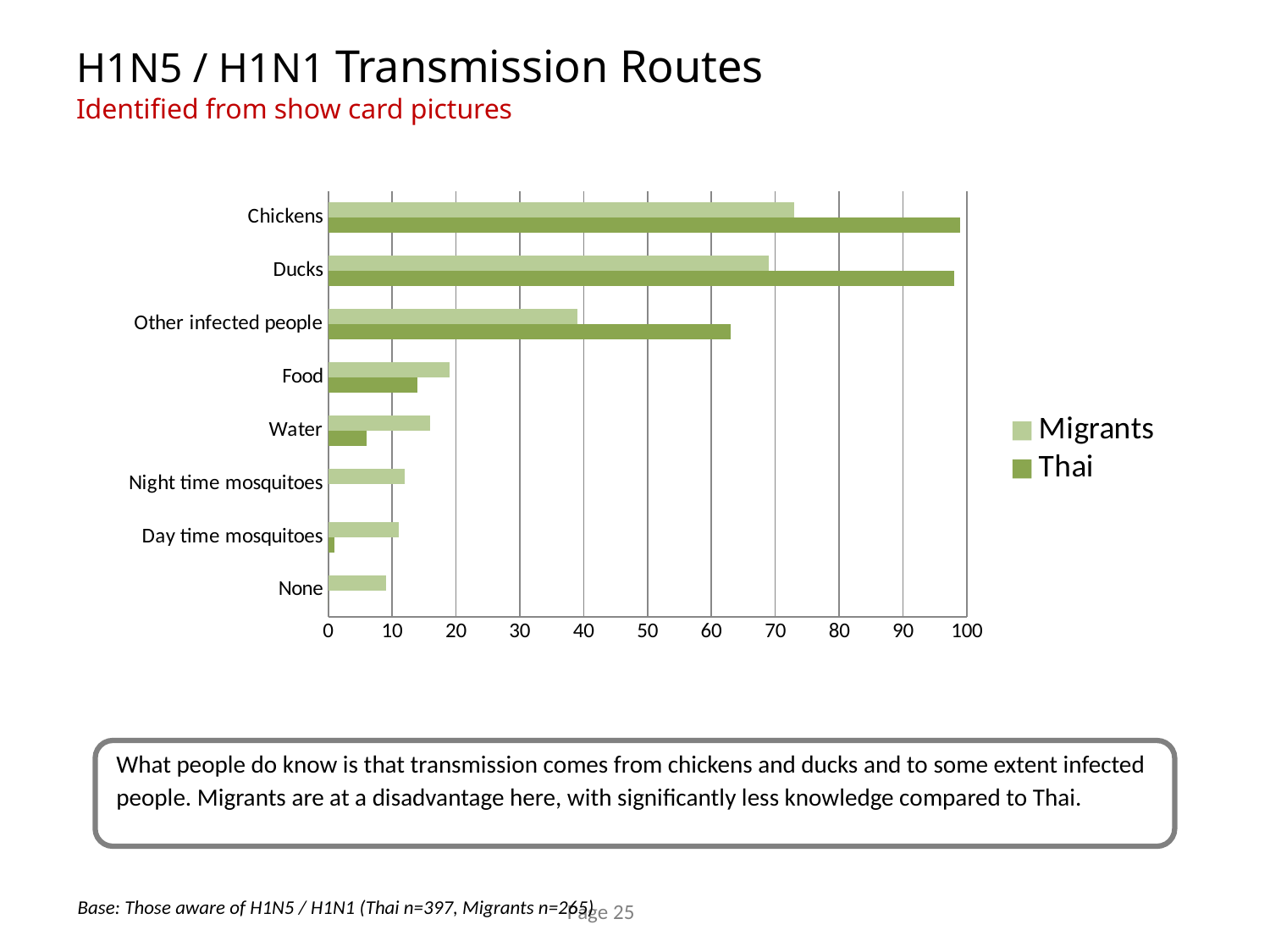
Which category has the lowest value for Migrants? None Is the Migrants value for Ducks greater or less than 60? greater Is the Thai value for Water greater or less than 10? less For Food, which series has the larger value, Migrants or Thai? Migrants How many series does the legend list? 2 For Other infected people, which series has the larger value, Migrants or Thai? Thai How many transmission route categories are plotted on the chart? 8 Is the Migrants value for Other infected people greater or less than 50? less What kind of chart is shown on the slide? Bar chart Which series is shown in the darker green colour? Thai Which category has the highest value for Migrants? Chickens